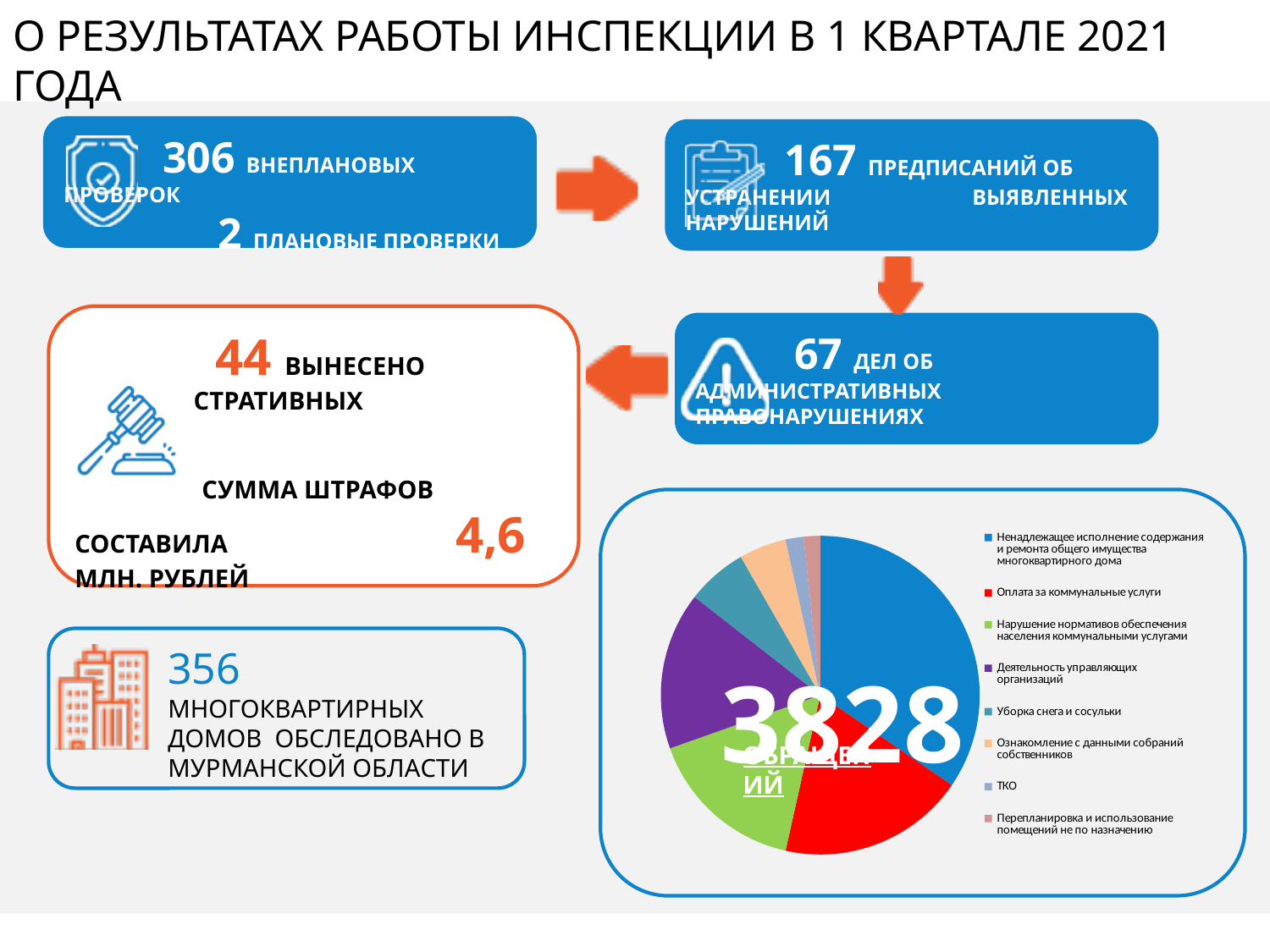
In the pie chart, which slice is larger: Нарушение нормативов обеспечения населения коммунальными услугами or Ознакомление с данными собраний собственников? Нарушение нормативов обеспечения населения коммунальными услугами In the pie chart, which slice is larger: Оплата за коммунальные услуги or Нарушение нормативов обеспечения населения коммунальными услугами? Оплата за коммунальные услуги What colour represents Оплата за коммунальные услуги in the pie chart? red What total number of appeals (обращений) is printed over the pie chart? 3828 In the pie chart, which slice is larger: Ненадлежащее исполнение содержания и ремонта общего имущества многоквартирного дома or Деятельность управляющих организаций? Ненадлежащее исполнение содержания и ремонта общего имущества многоквартирного дома Which category has the largest slice in the pie chart? Ненадлежащее исполнение содержания и ремонта общего имущества многоквартирного дома What kind of chart is shown on the slide? pie chart How many categories does the pie chart's legend list? 8